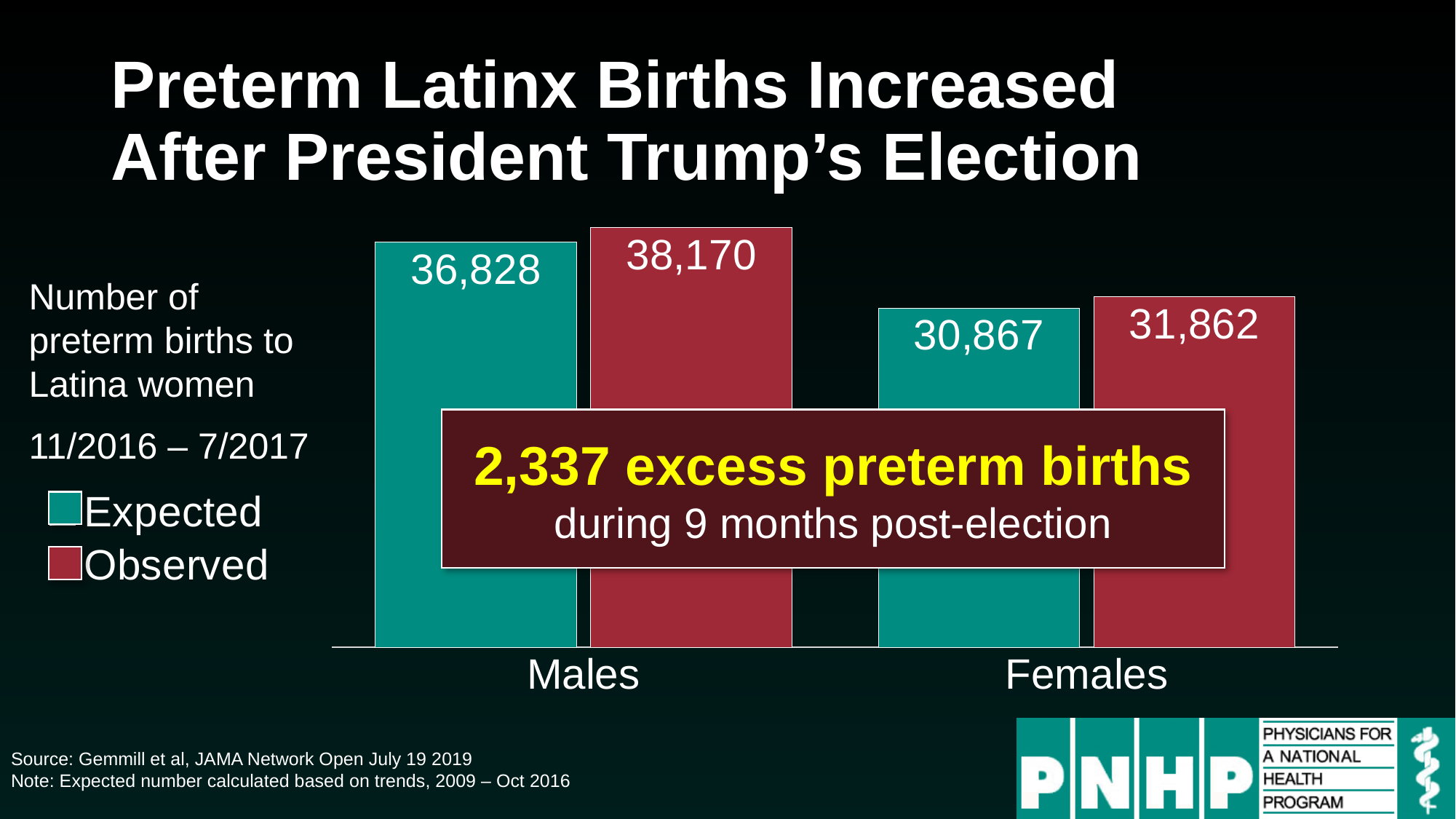
What is the observed number of preterm births for Females? 31,862 What type of chart is shown on the slide? Bar chart How many categories are shown on the x axis? 2 What is the observed number of preterm births for Males? 38,170 Which bar shows the highest value on the chart? Observed, Males How many series does the legend list? 2 What is the difference between the observed and expected preterm births for Females? 995 For Females, which is larger: the expected or the observed number of preterm births? Observed What is the difference between the observed and expected preterm births for Males? 1,342 Which bar shows the lowest value on the chart? Expected, Females What is the expected number of preterm births for Males? 36,828 What is the expected number of preterm births for Females? 30,867